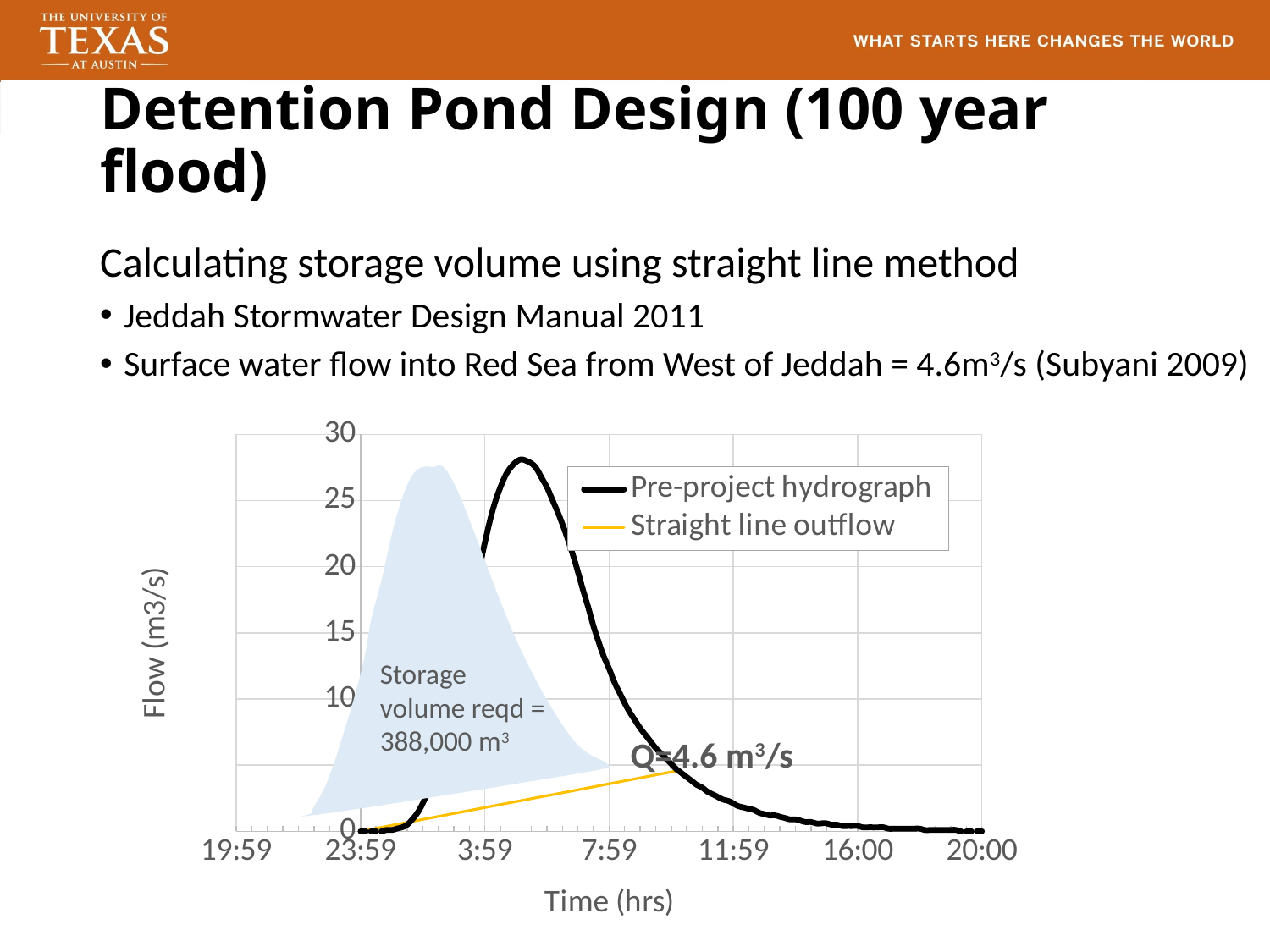
How many series does the chart legend list? 2 Which series reaches the higher peak flow, Pre-project hydrograph or Straight line outflow? Pre-project hydrograph What are the two series named in the chart legend? Pre-project hydrograph; Straight line outflow What flow rate Q is labelled at the end of the Straight line outflow? Q=4.6 m³/s Does the Straight line outflow rise or fall from 23:59 to its end point? rise Is the peak value of the Pre-project hydrograph greater or less than 30? less What storage volume is stated as required in the chart annotation? 388,000 m³ Is the peak value of the Pre-project hydrograph greater or less than 25? greater What kind of chart is shown on the slide? line chart Is the value of the Pre-project hydrograph at 16:00 greater or less than 5? less What is the title of the chart's vertical axis? Flow (m3/s) Does the Pre-project hydrograph rise or fall between 7:59 and 11:59? fall